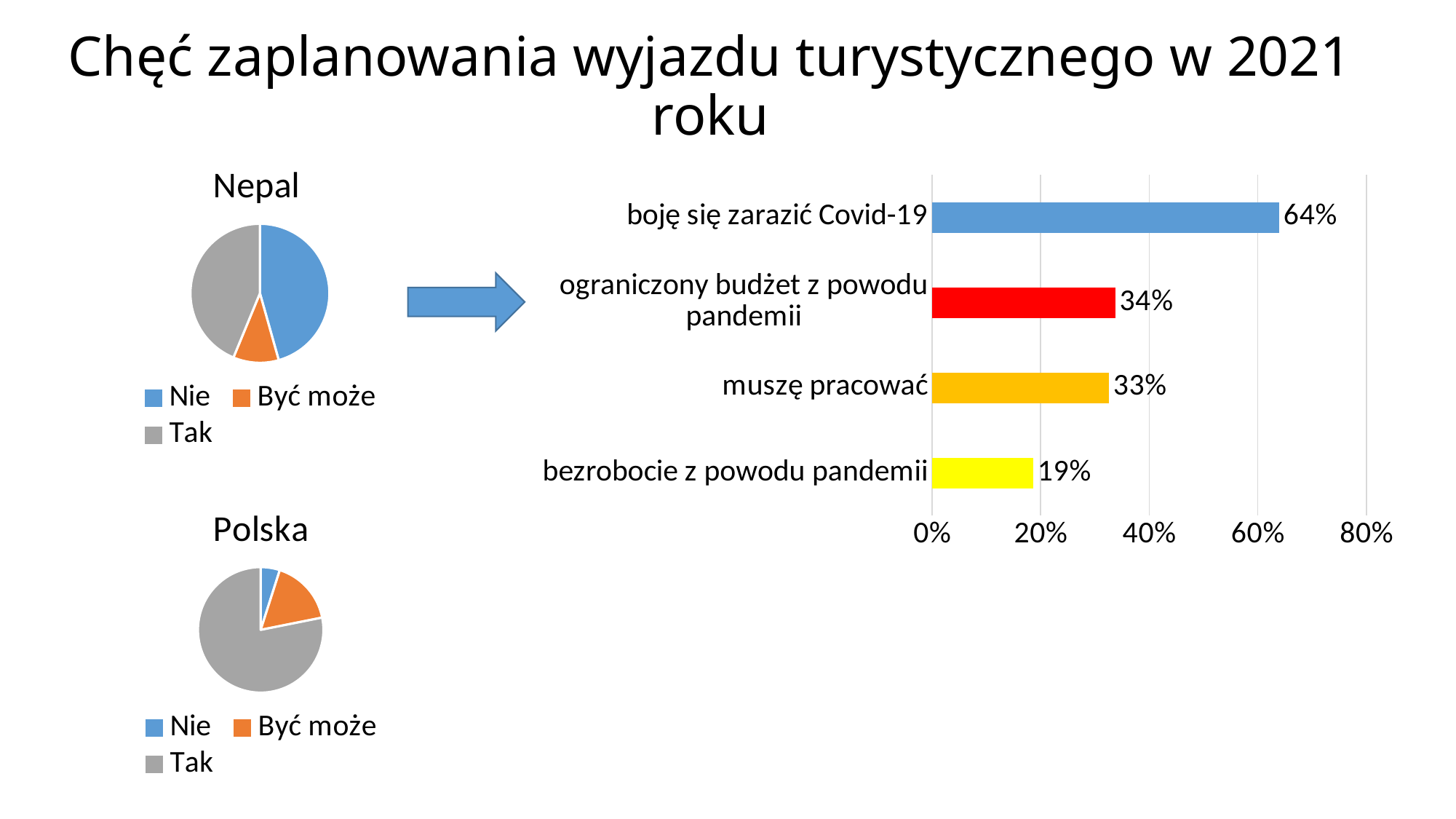
What kind of chart is the chart on the right of the slide? bar chart In the bar chart on the right, what is the value for "muszę pracować"? 33% In the bar chart on the right, what is the difference between "boję się zarazić Covid-19" and "ograniczony budżet z powodu pandemii"? 30% In the bar chart on the right, how many categories are shown? 4 In the Nepal chart, which category has the smallest slice? Być może How many entries does the legend of the Nepal chart list? 3 In the Polska chart, which slice is larger: Nie or Być może? Być może In the bar chart on the right, what is the value for "boję się zarazić Covid-19"? 64% In the bar chart on the right, what is the value for "bezrobocie z powodu pandemii"? 19% In the bar chart on the right, which category has the highest value? boję się zarazić Covid-19 In the bar chart on the right, which category has the lowest value? bezrobocie z powodu pandemii In the Polska chart, which category has the largest slice? Tak